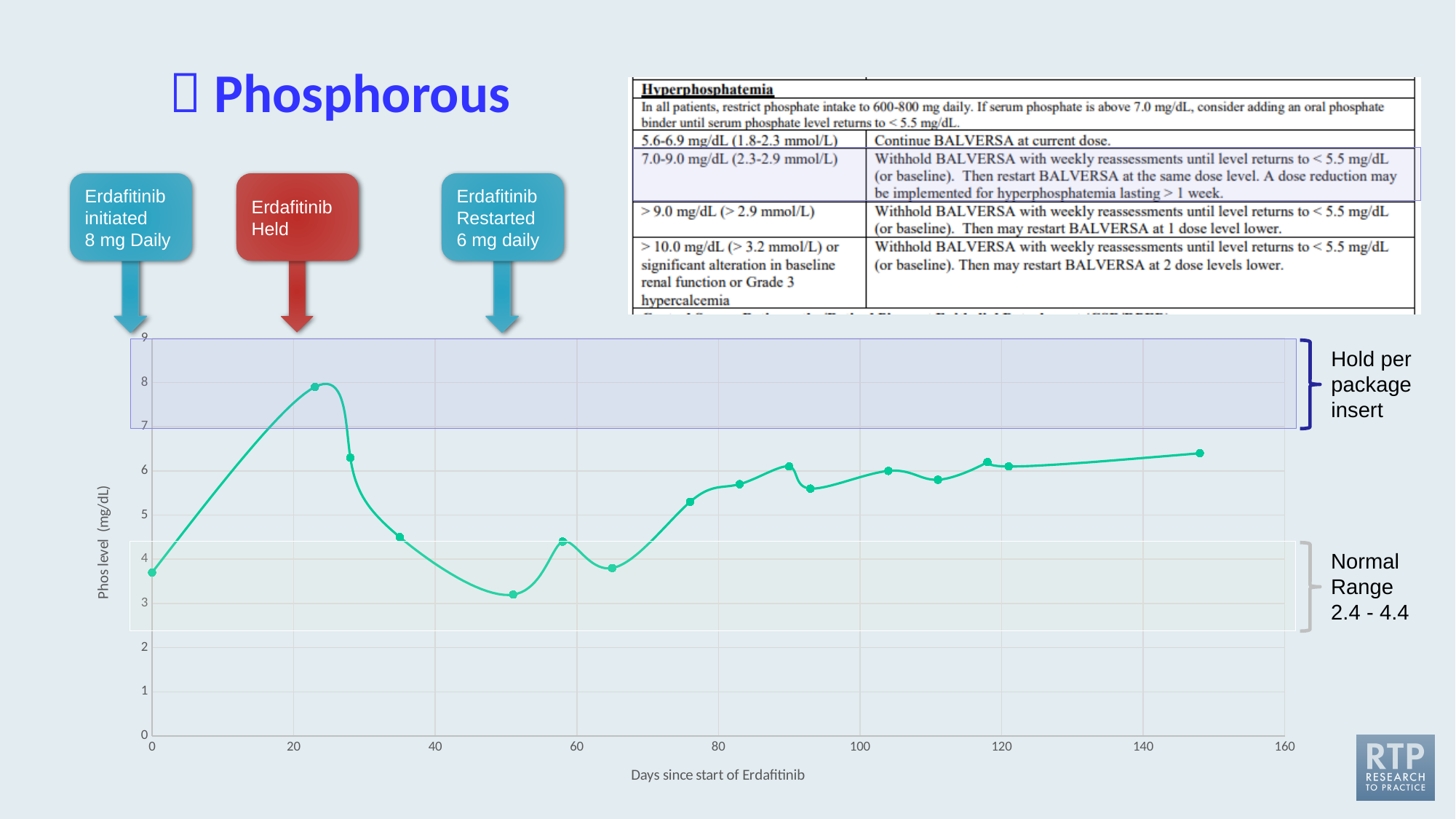
Is the phosphorus value at day 0 greater or less than 4? less What is the label of the y axis of the chart? Phos level (mg/dL) Is the phosphorus value at day 0 greater or less than 3? greater Which is higher: the peak phosphorus value near day 23 or the final value near day 148? the peak near day 23 What kind of chart is shown on the slide? line chart Is the lowest phosphorus value on the chart greater or less than 4? less Does the phosphorus level rise or fall between day 0 and the peak near day 23? rise Which is higher: the phosphorus value at day 0 or the final value near day 148? the final value near day 148 What is the label of the x axis of the chart? Days since start of Erdafitinib How many data points are plotted on the line? 16